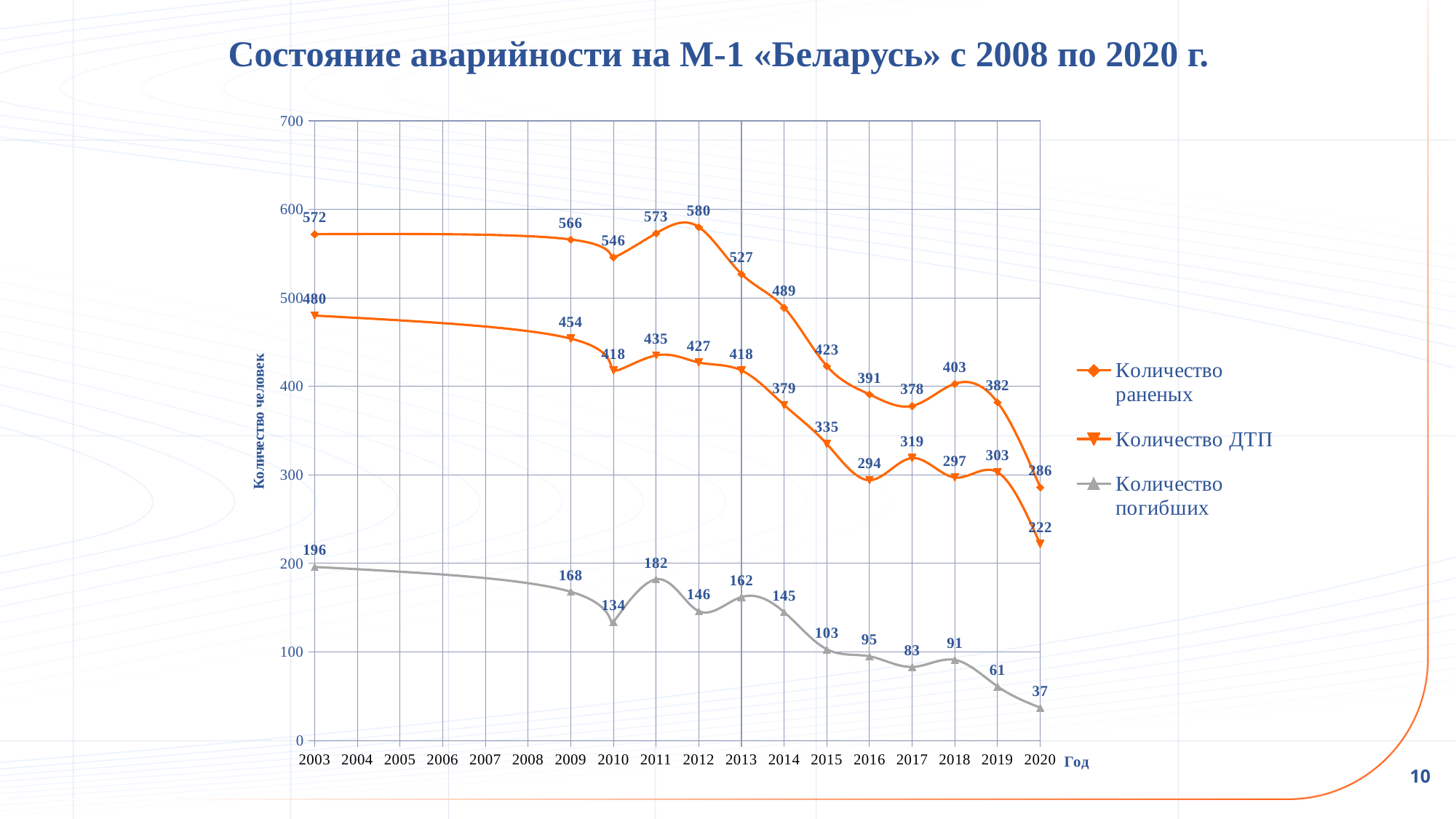
In which year is Количество раненых highest? 2012 How many data points does the Количество ДТП series have? 13 What is the difference between Количество ДТП in 2003 and in 2020? 258 What is the value of Количество ДТП in 2020? 222 What is the value of Количество раненых in 2012? 580 How many series does the legend list? 3 In which year is Количество погибших lowest? 2020 Does Количество погибших generally rise or fall from 2003 to 2020? fall What is the value of Количество погибших in 2015? 103 What kind of chart is shown on the slide? line chart Which is larger: Количество погибших in 2011 or in 2013? 2011 Is the value of Количество раненых in 2020 greater or less than 300? less